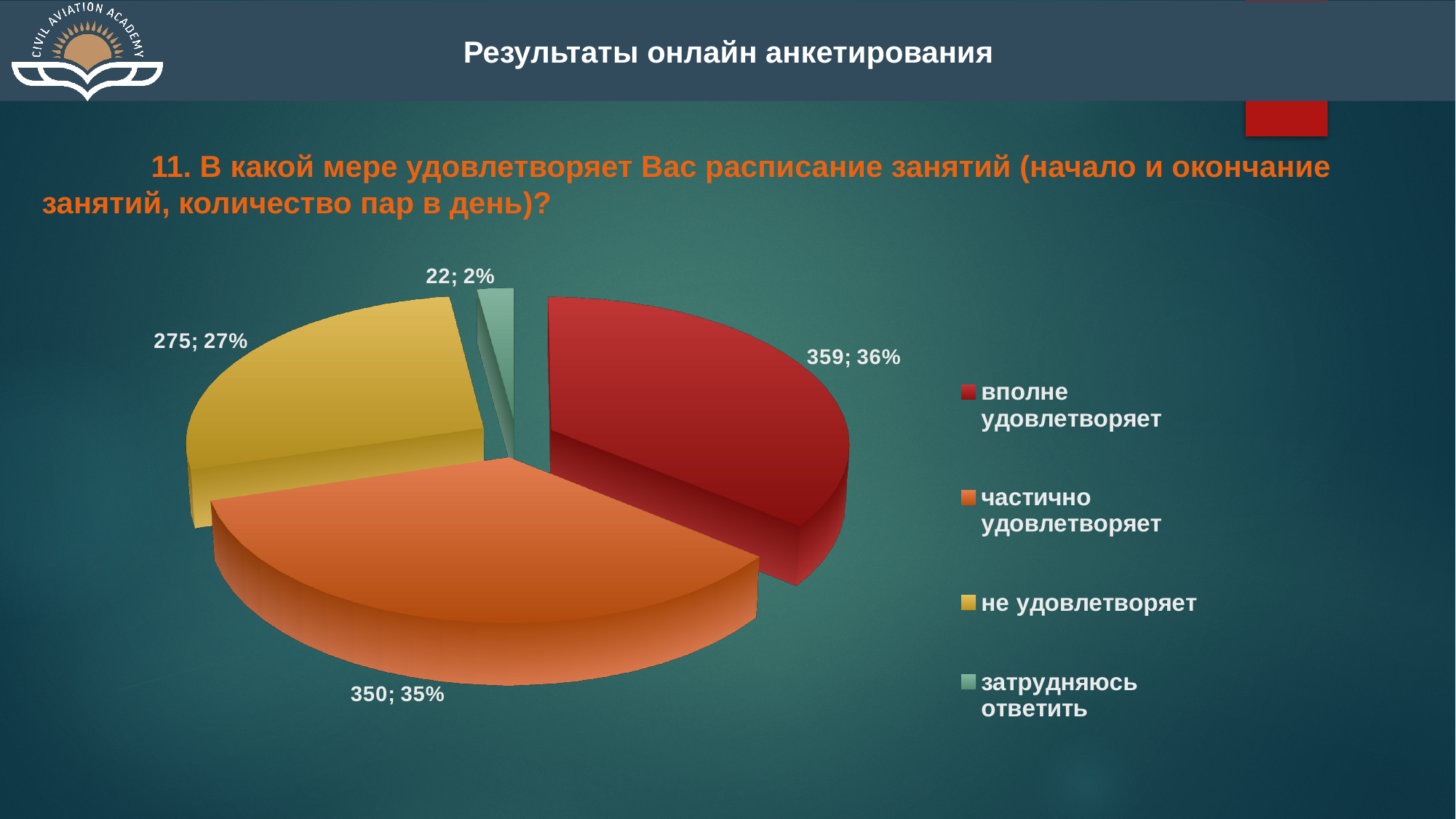
What is the count for 'не удовлетворяет'? 275 What is the count for 'вполне удовлетворяет'? 359 Which category has the smallest slice? затрудняюсь ответить What type of chart is shown on the slide? pie chart What colour is the slice for 'не удовлетворяет'? yellow Which is larger, the count for 'не удовлетворяет' or for 'затрудняюсь ответить'? не удовлетворяет How many slices does the pie chart have? 4 What percentage is shown for 'частично удовлетворяет'? 35% How many entries does the legend list? 4 What is the difference between the counts for 'вполне удовлетворяет' and 'частично удовлетворяет'? 9 Which category has the largest slice? вполне удовлетворяет What share of the pie does 'затрудняюсь ответить' represent? 2%